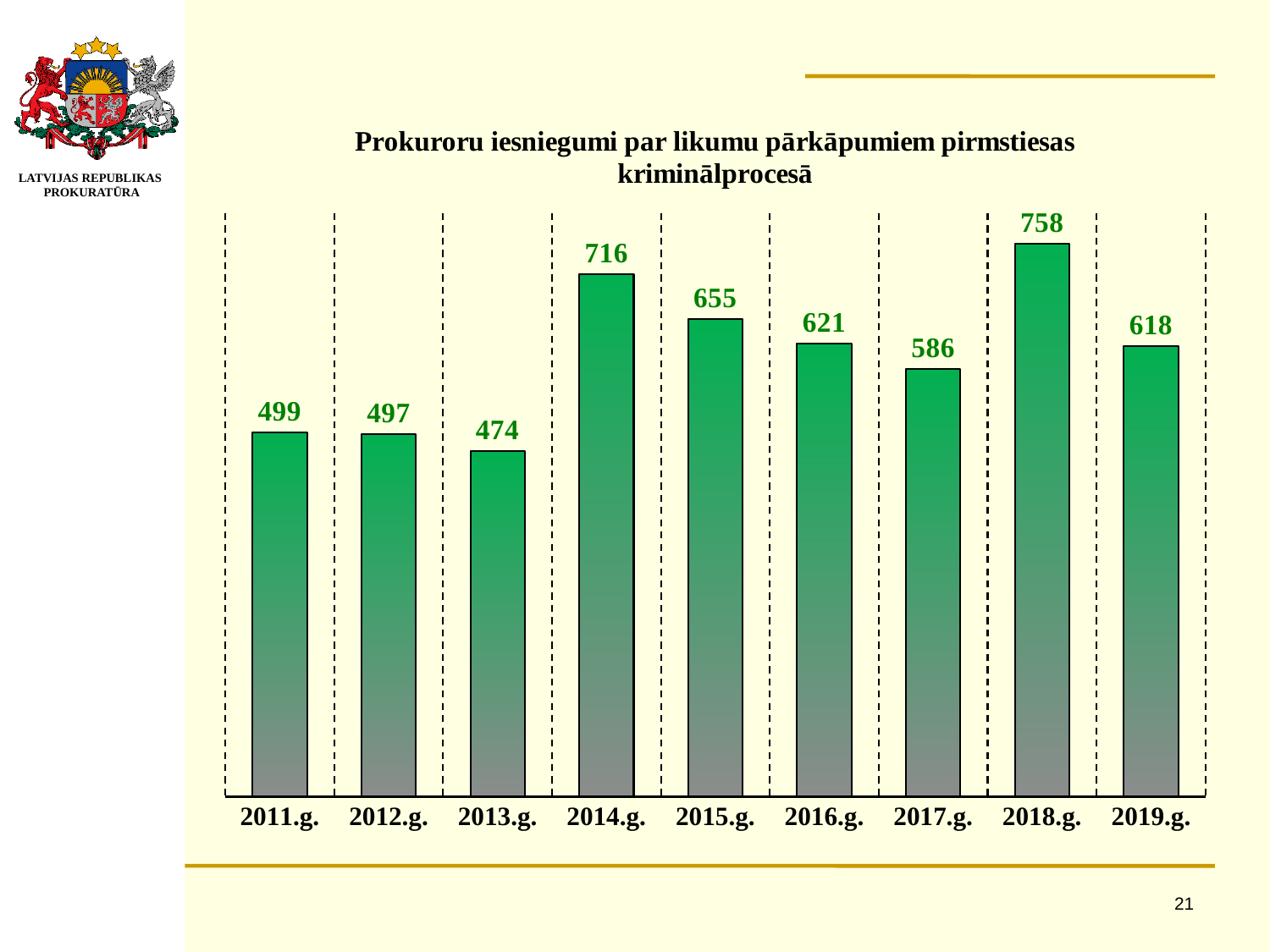
Which year has the lowest value? 2013.g. What is the difference between the values for 2018.g. and 2019.g.? 140 How many years are shown on the x axis? 9 What is the value for 2014.g.? 716 What is the value for 2011.g.? 499 What is the title of the chart? Prokuroru iesniegumi par likumu pārkāpumiem pirmstiesas kriminālprocesā What is the difference between the values for 2014.g. and 2013.g.? 242 What is the value for 2017.g.? 586 Do the values rise or fall from 2016.g. to 2017.g.? fall Which is larger, the value for 2015.g. or the value for 2016.g.? 2015.g. What kind of chart is shown on the slide? bar chart Which year has the highest value? 2018.g.